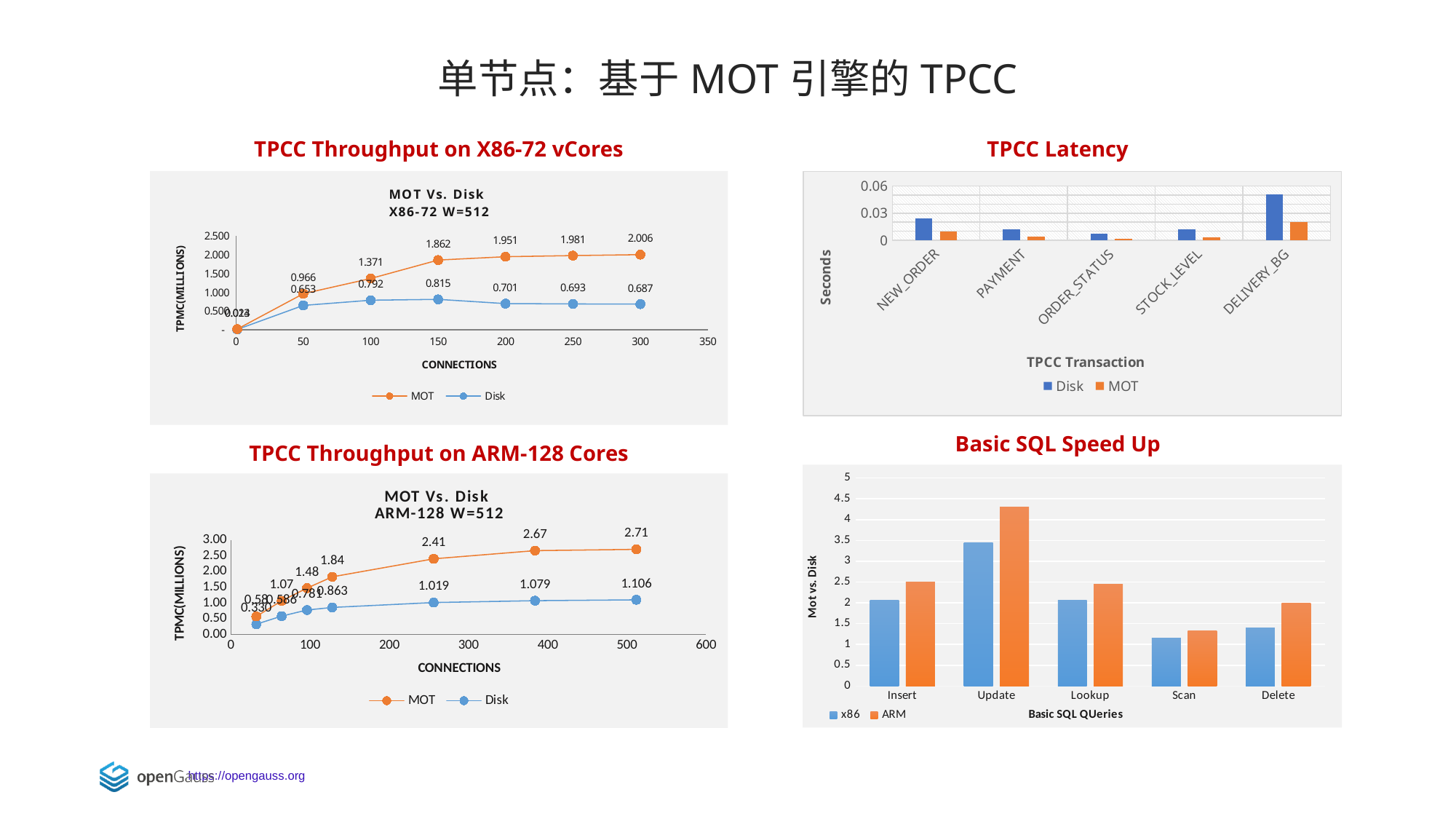
In the TPCC Throughput on X86-72 vCores chart, what is the difference between the MOT and Disk values at 300 connections? 1.319 In the Basic SQL Speed Up chart, which query has the highest ARM speed up? Update In the TPCC Throughput on X86-72 vCores chart, what is the Disk value at 150 connections? 0.815 In the TPCC Throughput on X86-72 vCores chart, what is the MOT value at 300 connections? 2.006 In the TPCC Throughput on X86-72 vCores chart, which series has the higher value at 200 connections, MOT or Disk? MOT In the TPCC Throughput on ARM-128 Cores chart, does the MOT series rise or fall as connections increase? rises In the Basic SQL Speed Up chart, how many query categories are shown on the x axis? 5 In the TPCC Latency chart, is the Disk value for DELIVERY_BG greater or less than 0.03? greater In the TPCC Latency chart, which transaction has the highest Disk latency? DELIVERY_BG In the TPCC Throughput on ARM-128 Cores chart, what is the highest MOT value shown? 2.71 In the TPCC Throughput on ARM-128 Cores chart, what is the Disk value at the rightmost data point? 1.106 In the TPCC Latency chart, how many series does the legend list? 2